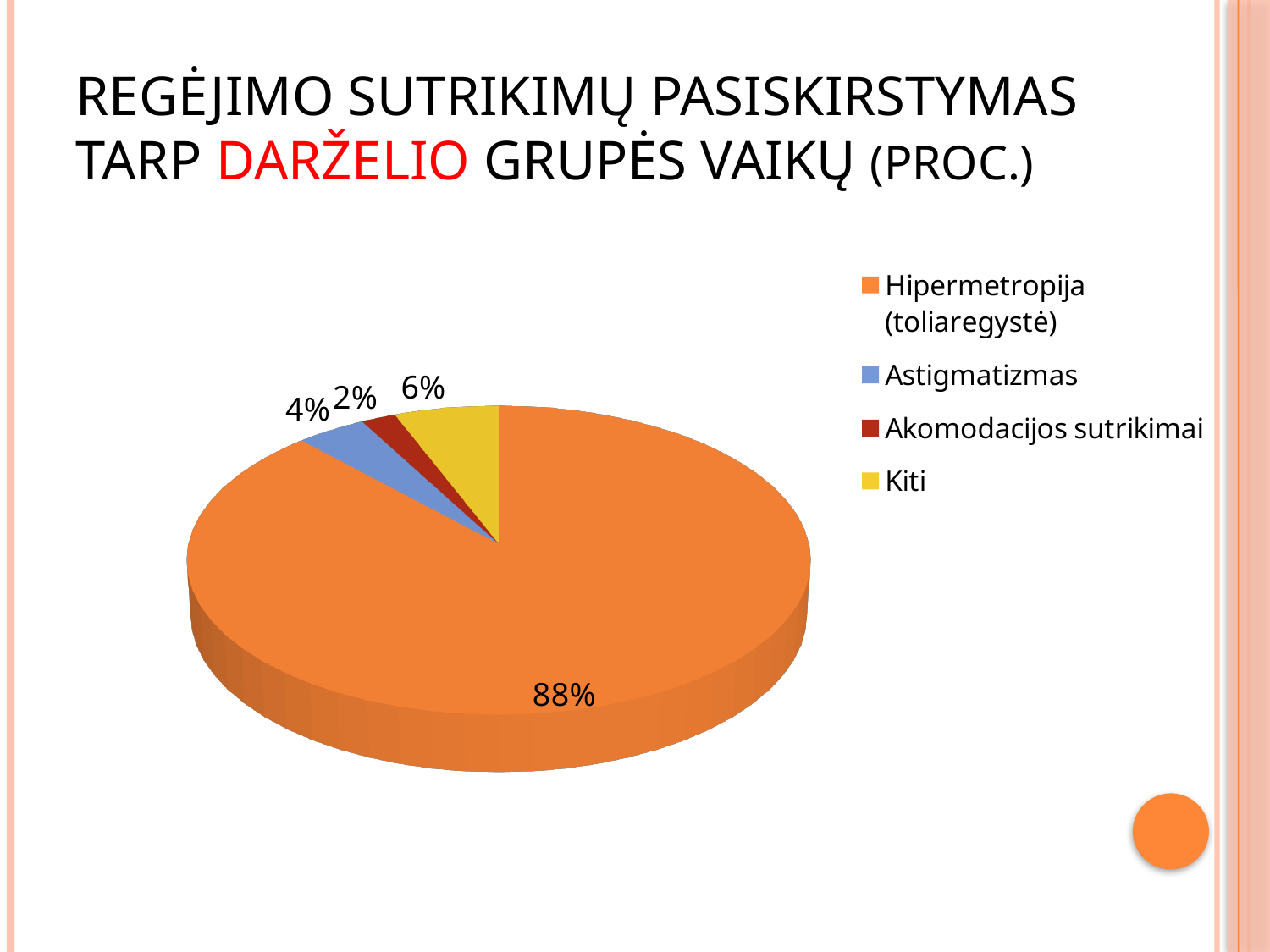
How many entries does the legend list? 4 What is the difference in percentage points between Hipermetropija (toliaregystė) and Kiti? 82 What percentage of the pie is Hipermetropija (toliaregystė)? 88% Which category has the largest share of the pie? Hipermetropija (toliaregystė) What colour is the slice for Kiti? yellow How many slices does the pie chart have? 4 What percentage of the pie is Kiti? 6% Which is larger, the share for Kiti or the share for Astigmatizmas? Kiti What percentage of the pie is Akomodacijos sutrikimai? 2% What kind of chart is shown on the slide? pie chart Which category has the smallest share of the pie? Akomodacijos sutrikimai What percentage of the pie is Astigmatizmas? 4%